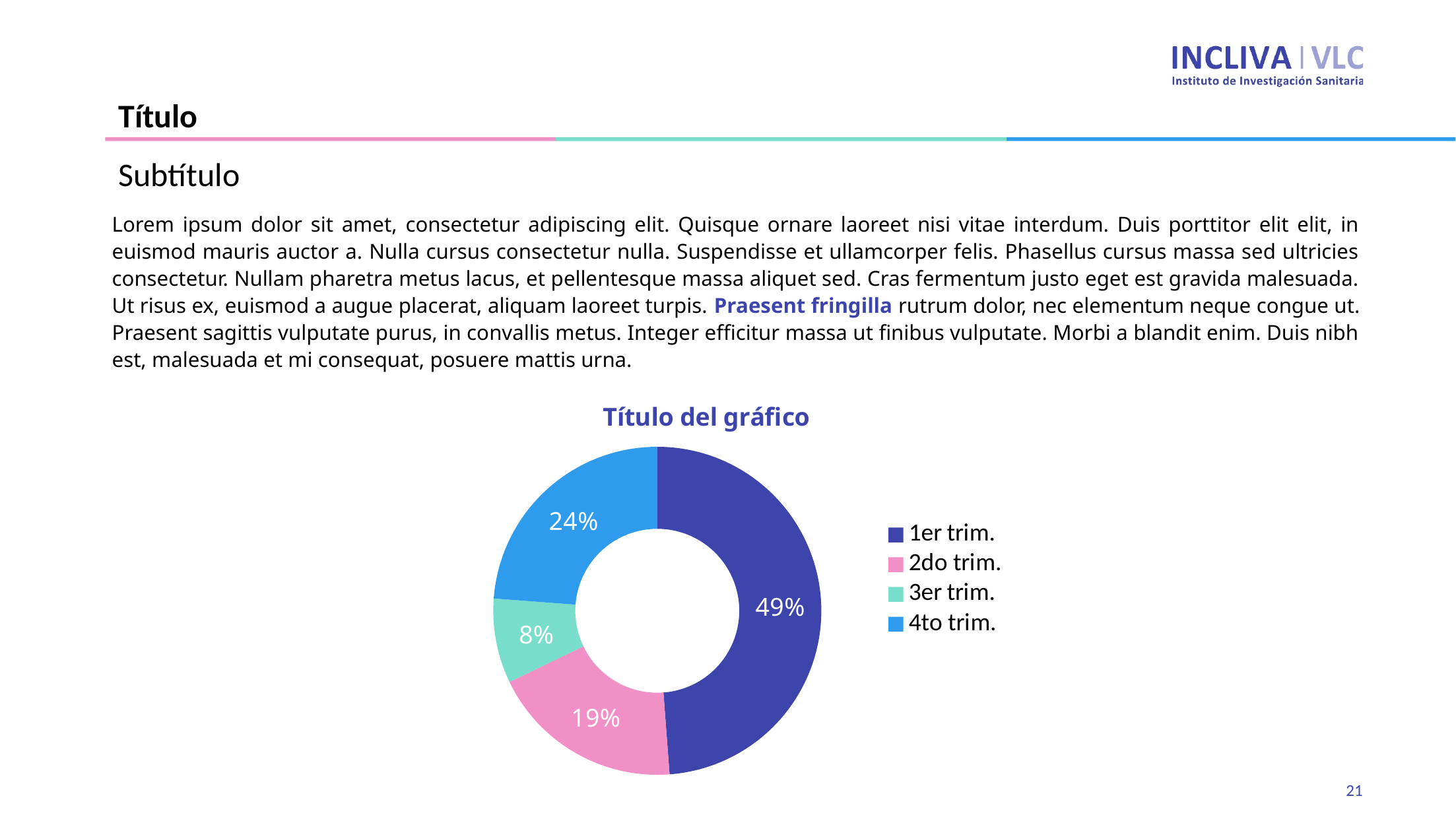
What share of the chart does 3er trim. represent? 8% What share of the chart does 4to trim. represent? 24% What share of the chart does 2do trim. represent? 19% Which category has the largest slice? 1er trim. Which category has the smallest slice? 3er trim. What is the title of the chart? Título del gráfico How many categories does the chart show? 4 Which is larger, 2do trim. or 4to trim.? 4to trim. What kind of chart is shown on the slide? Doughnut chart What is the difference in percentage points between 2do trim. and 3er trim.? 11 What is the difference in percentage points between 1er trim. and 4to trim.? 25